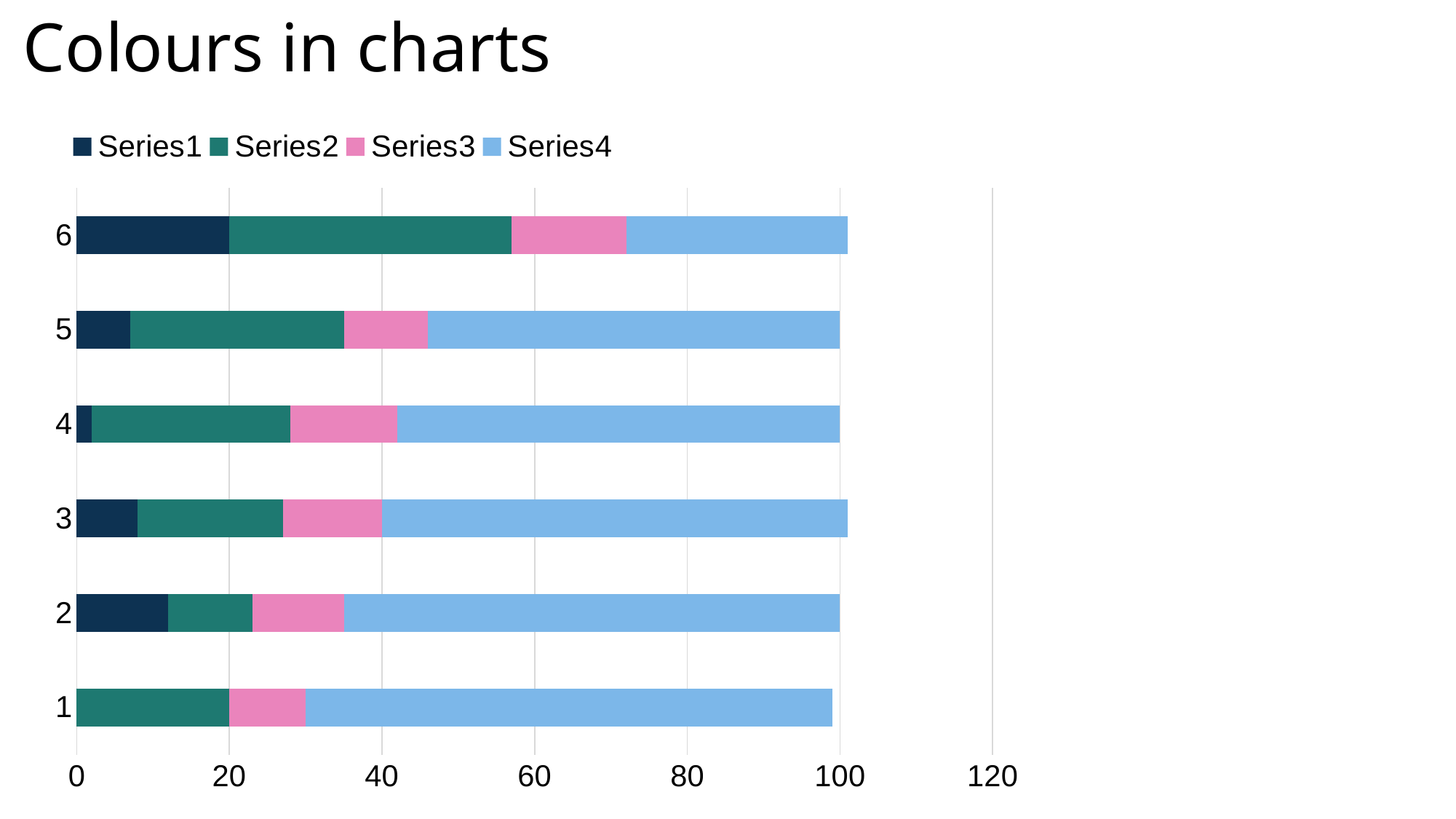
How many series does the legend list? 4 Which category has the largest Series1 segment? 6 What kind of chart is shown on the slide? Stacked bar chart Which series is shown in pink in the legend? Series3 Is the Series1 value for category 4 greater or less than 20? less Is the Series1 segment larger for category 6 or category 4? 6 How many categories are plotted on the chart? 6 Which category has the largest Series2 segment? 6 What is the title of the slide? Colours in charts Is the Series4 value for category 5 greater or less than 40? greater Is the Series4 value for category 6 greater or less than 40? less